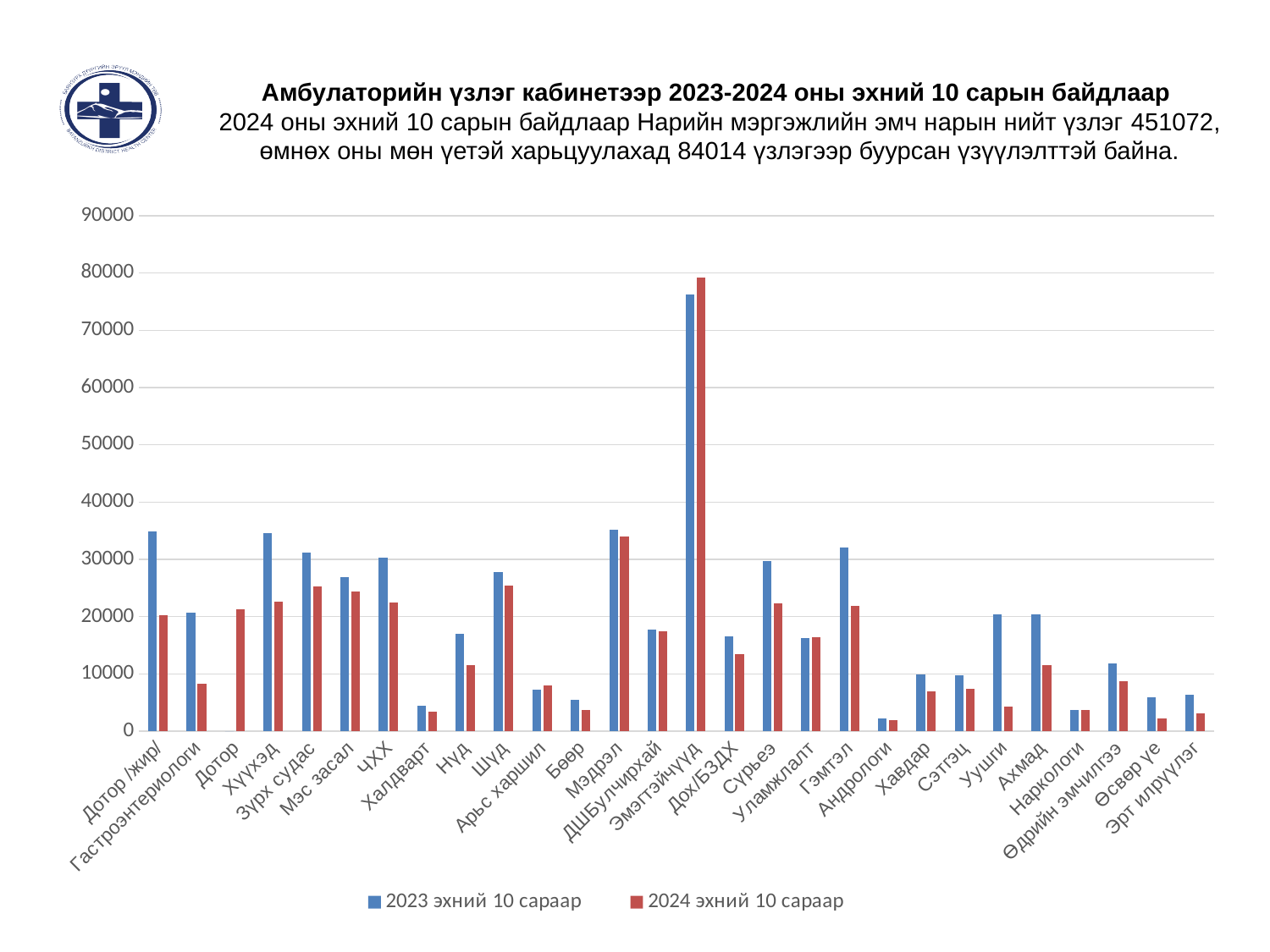
How many categories are shown along the x axis? 28 Which category has the highest value for the 2024 эхний 10 сараар series? Эмэгтэйчүүд How many series does the legend list? 2 Is the 2024 эхний 10 сараар value for Мэдрэл greater or less than 30000? greater Is the 2024 эхний 10 сараар value for Гастроэнтерологи greater or less than 10000? less Is the 2024 эхний 10 сараар value for Уушги greater or less than 10000? less What kind of chart is shown on the slide? bar chart Which colour represents the 2024 эхний 10 сараар series? red Which category has the lowest value for the 2023 эхний 10 сараар series? Дотор Which category has the highest value for the 2023 эхний 10 сараар series? Эмэгтэйчүүд For Дотор /жир/, which series has the larger value, 2023 эхний 10 сараар or 2024 эхний 10 сараар? 2023 эхний 10 сараар